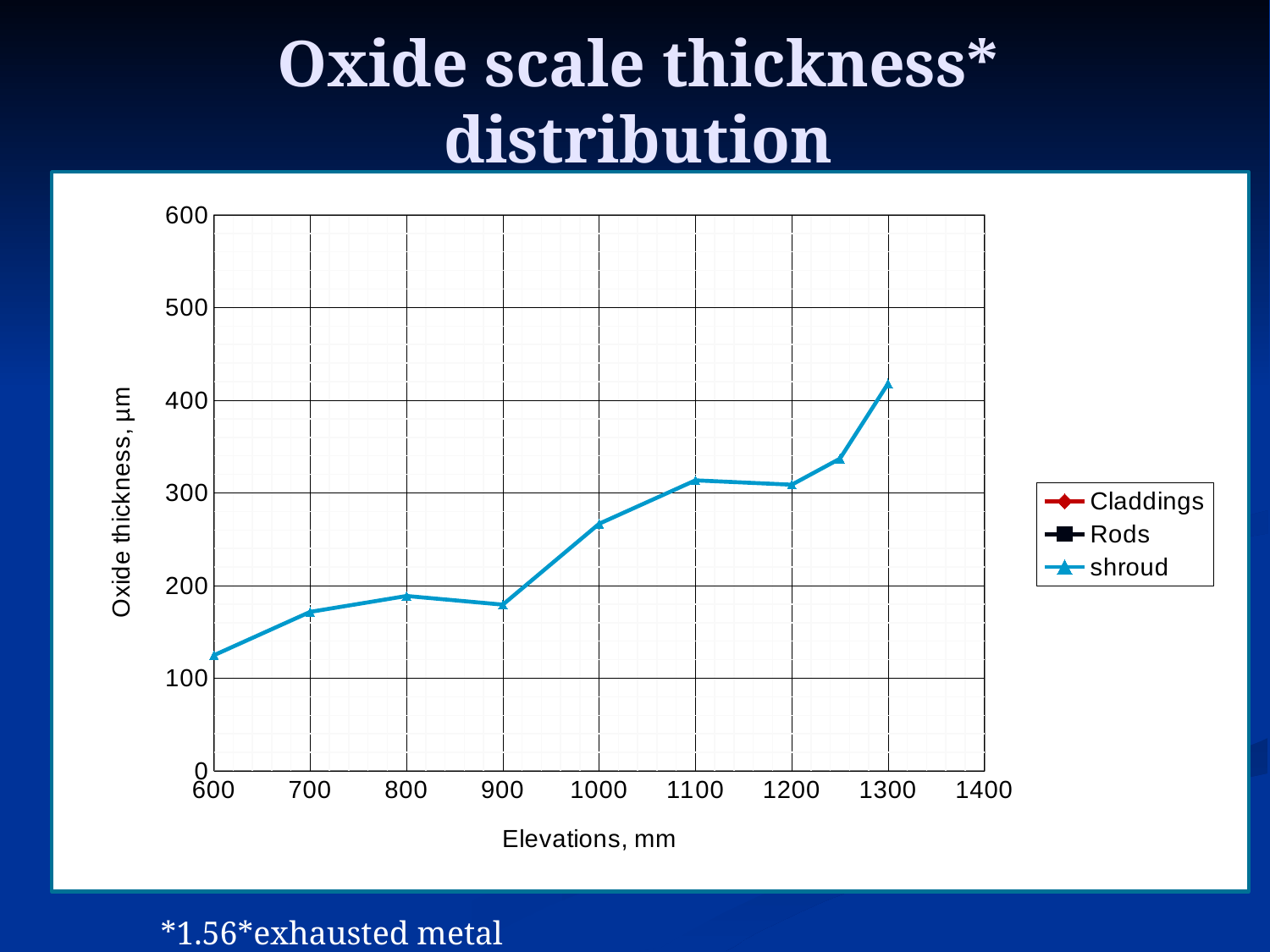
How many data points are plotted for the shroud series? 9 At which elevation is the shroud oxide thickness lowest? 600 How many series does the legend list? 3 Which has the larger shroud oxide thickness, 1000 mm or 800 mm elevation? 1000 mm Is the shroud oxide thickness at 1000 mm greater or less than 200? greater What kind of chart is shown on the slide? line chart Is the shroud oxide thickness at 600 mm greater or less than 200? less Is the shroud oxide thickness at 1250 mm greater or less than 300? greater What is the label of the y axis? Oxide thickness, µm At which elevation is the shroud oxide thickness highest? 1300 Does the shroud oxide thickness generally rise or fall as elevation increases from 600 to 1300 mm? rise